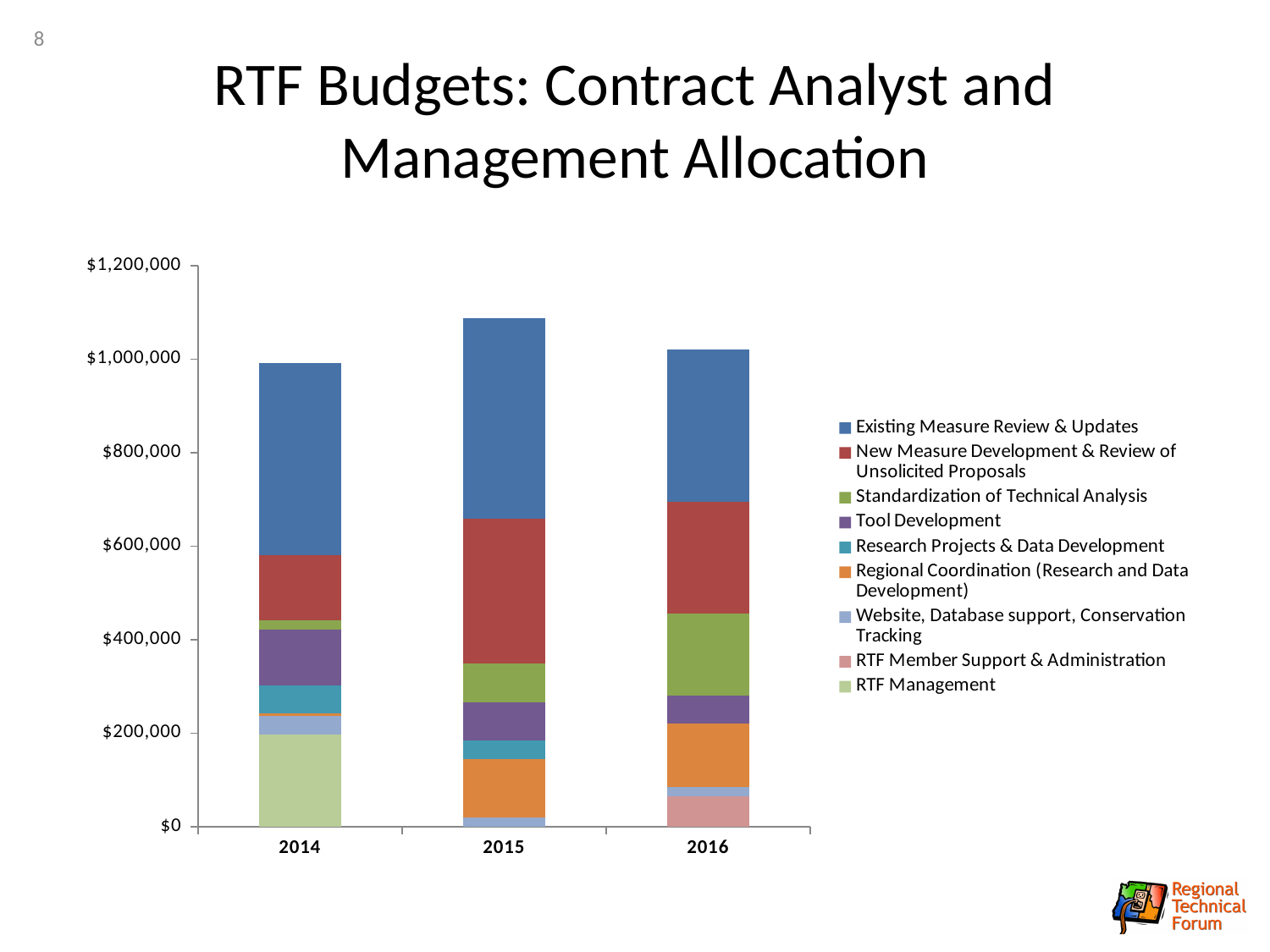
Does the total budget rise or fall from 2014 to 2015? rise Which year's bar is taller, 2015 or 2014? 2015 Which year has the highest total budget bar? 2015 Which year has the lowest total budget bar? 2014 Which year is the only one with an RTF Management segment in its bar? 2014 Is the total bar for 2014 greater or less than $1,000,000? less Is the total bar for 2016 greater or less than $800,000? greater How many series does the chart's legend list? 9 What kind of chart is shown on the slide? Stacked bar chart How many years are shown on the x axis of the chart? 3 Which series is shown at the top of each stacked bar? Existing Measure Review & Updates Is the total bar for 2015 greater or less than $1,000,000? greater